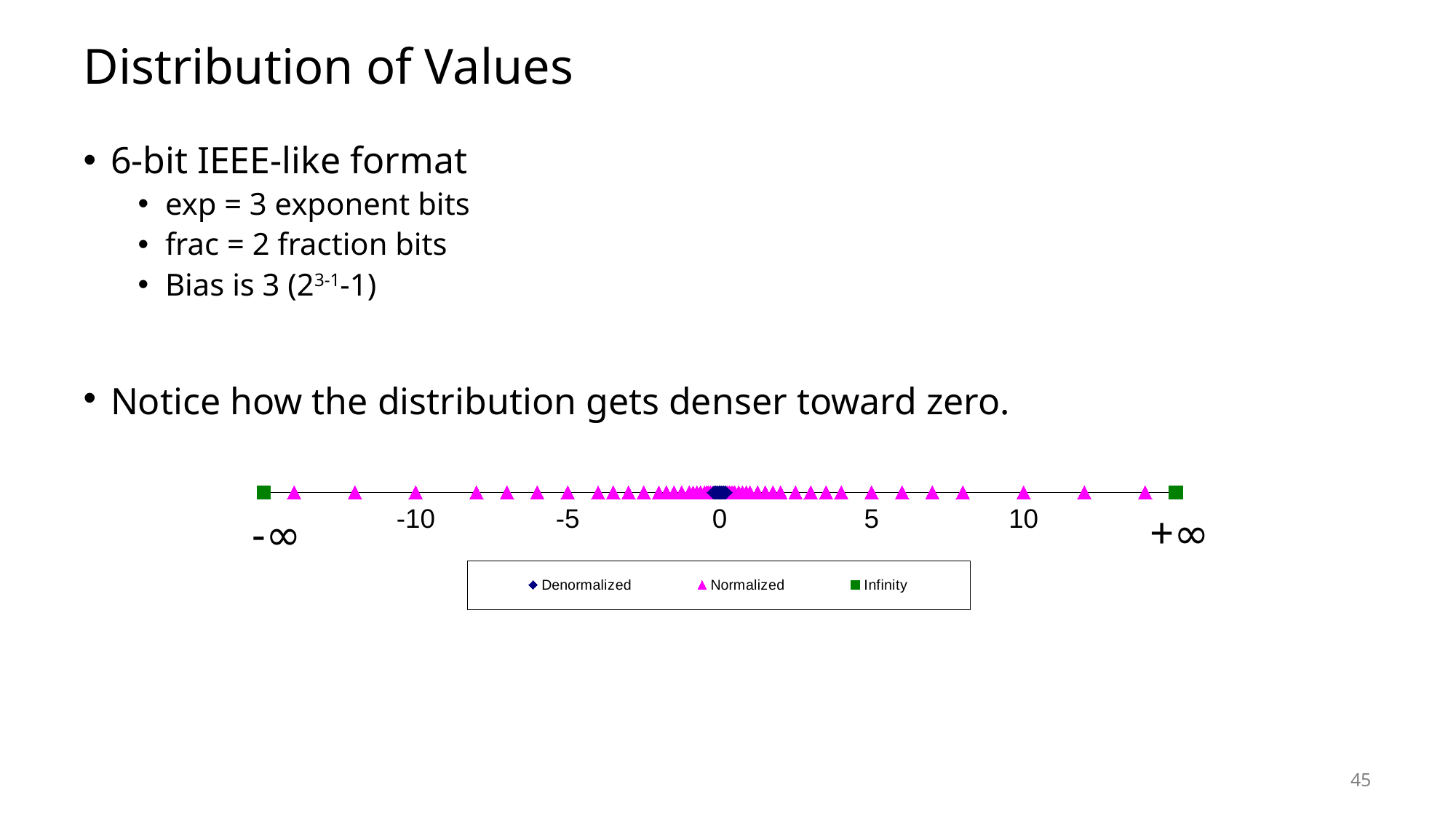
Which series is drawn with magenta triangle markers? Normalized Which series is drawn with green square markers? Infinity How many series does the chart legend list? 3 How many Infinity markers are plotted on the chart? 2 Which series has its markers clustered closest to zero? Denormalized Which series has markers at the extreme ends of the axis? Infinity Is the rightmost Normalized marker greater or less than 10? greater What kind of chart is shown on the slide? scatter chart Moving away from zero, does the spacing between Normalized markers increase or decrease? increase How many numeric tick labels are shown on the chart's axis? 5 What label appears at the far left end of the chart's axis? -∞ What label appears at the far right end of the chart's axis? +∞